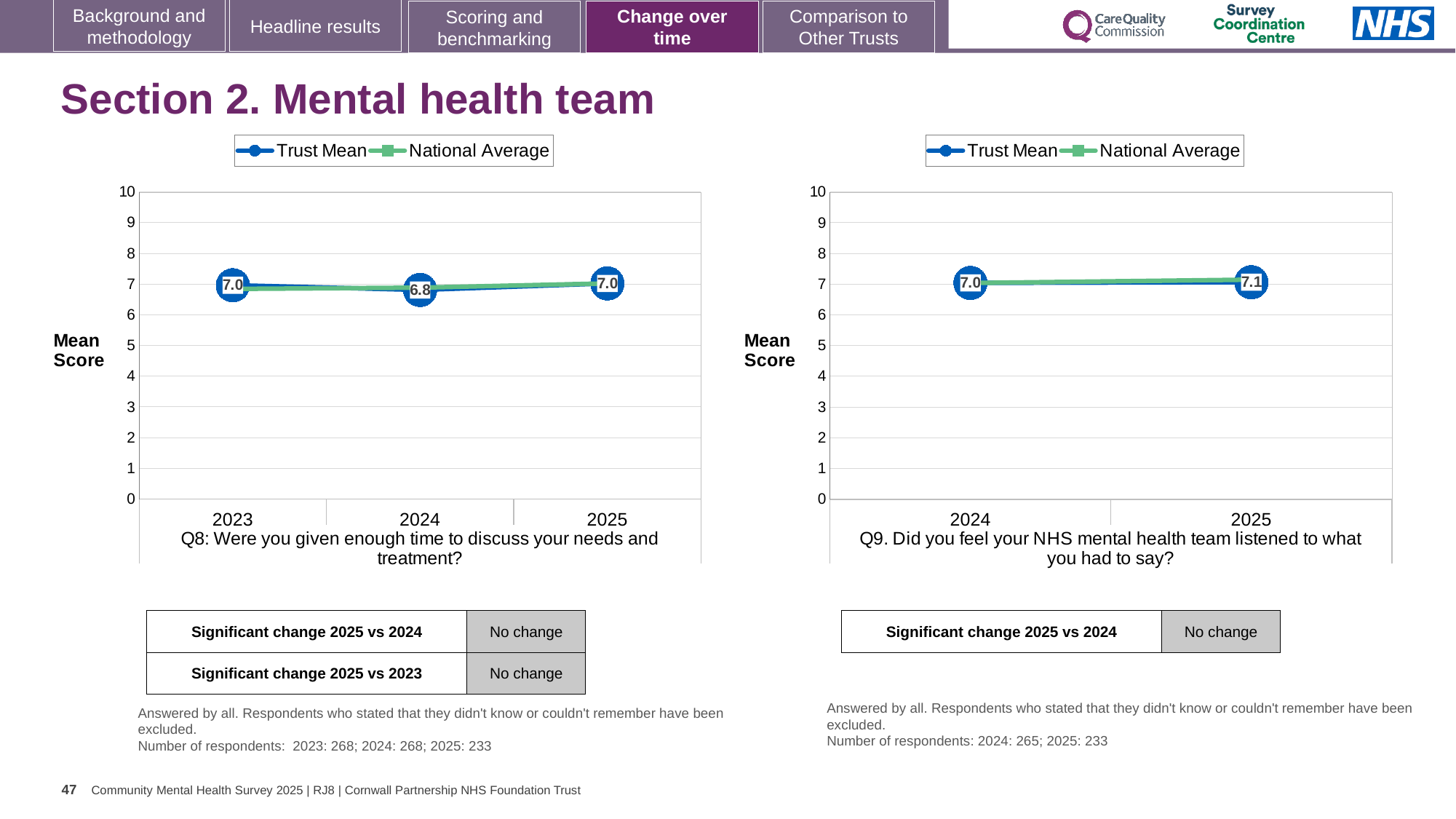
What kind of chart is the Q9 chart on the right? line chart In the Q8 chart on the left, what is the difference between the Trust Mean for 2023 and 2024? 0.2 In the Q9 chart on the right, does the Trust Mean rise or fall from 2024 to 2025? rise In the Q8 chart on the left, what is the Trust Mean for 2024? 6.8 In the Q9 chart on the right, what is the Trust Mean for 2025? 7.1 In the Q9 chart on the right, what is the Trust Mean for 2024? 7.0 In the Q8 chart on the left, what is the Trust Mean for 2023? 7.0 How many series does the legend of the Q9 chart on the right list? 2 In the Q8 chart on the left, which year has the lowest Trust Mean? 2024 How many years are plotted in the Q8 chart on the left? 3 In the Q8 chart on the left, is the Trust Mean higher in 2023 or 2024? 2023 In the Q9 chart on the right, is the National Average for 2025 greater or less than 5? greater